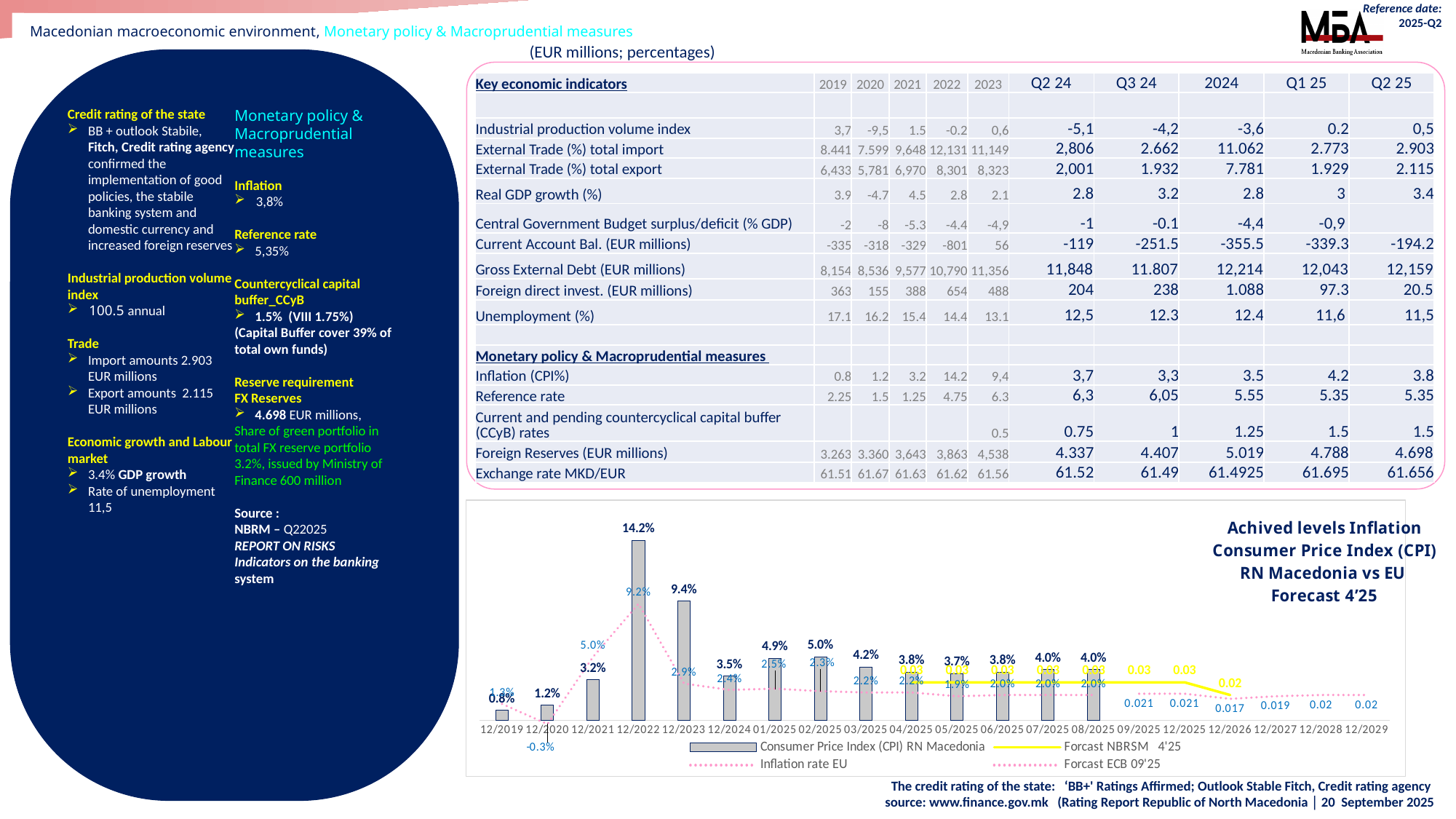
What type of chart is shown on the slide? Combined bar and line chart What is the Forcast ECB 09'25 value for 12/2026? 0.017 What is the Inflation rate EU value for 12/2020? -0.3% Which is larger for 12/2021: the CPI RN Macedonia value or the Inflation rate EU value? Inflation rate EU What is the difference between the CPI RN Macedonia values for 12/2022 and 12/2023? 4.8% What is the Consumer Price Index (CPI) RN Macedonia value for 08/2025? 4.0% Does the CPI RN Macedonia series rise or fall from 12/2022 to 12/2024? Fall What is the Consumer Price Index (CPI) RN Macedonia value for 12/2022? 14.2% How many series does the chart legend list? 4 Which period has the highest Consumer Price Index (CPI) RN Macedonia bar? 12/2022 Which period has the lowest Consumer Price Index (CPI) RN Macedonia bar? 12/2019 What is the Forcast NBRSM 4'25 value for 12/2026? 0.02